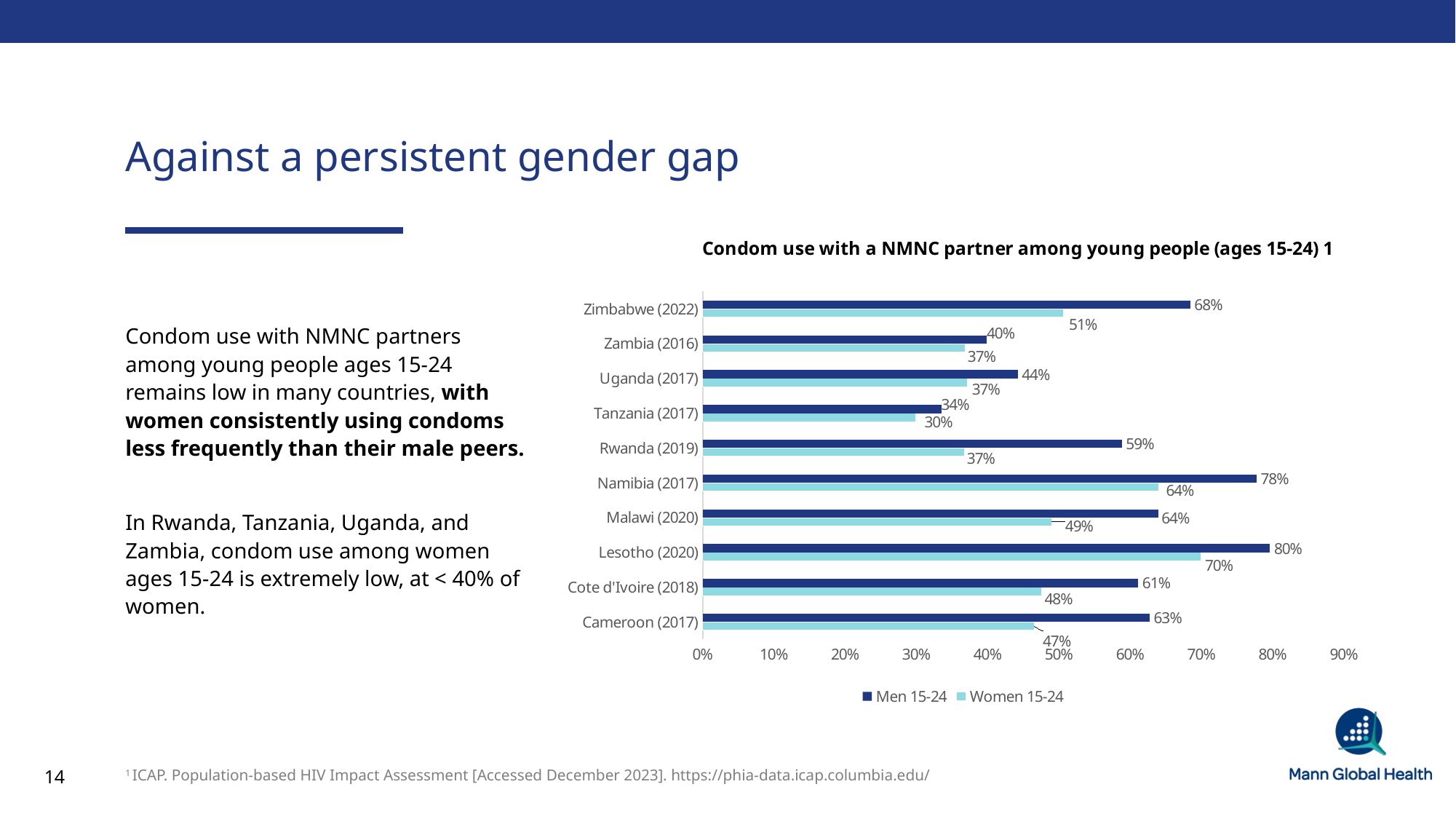
Which is larger: the Women 15-24 value for Namibia (2017) or for Malawi (2020)? Namibia (2017) What is the value for Men 15-24 in Zimbabwe (2022)? 68% Which country has the lowest value for Women 15-24? Tanzania (2017) How many countries are shown on the chart? 10 What is the value for Women 15-24 in Lesotho (2020)? 70% What is the value for Women 15-24 in Tanzania (2017)? 30% Which country has the highest value for Men 15-24? Lesotho (2020) What kind of chart is shown on the slide? Bar chart What is the title of the chart? Condom use with a NMNC partner among young people (ages 15-24) How many series does the legend list? 2 Is the value for Men 15-24 in Cote d'Ivoire (2018) greater or less than 50%? greater What is the difference between Men 15-24 and Women 15-24 in Rwanda (2019)? 22%